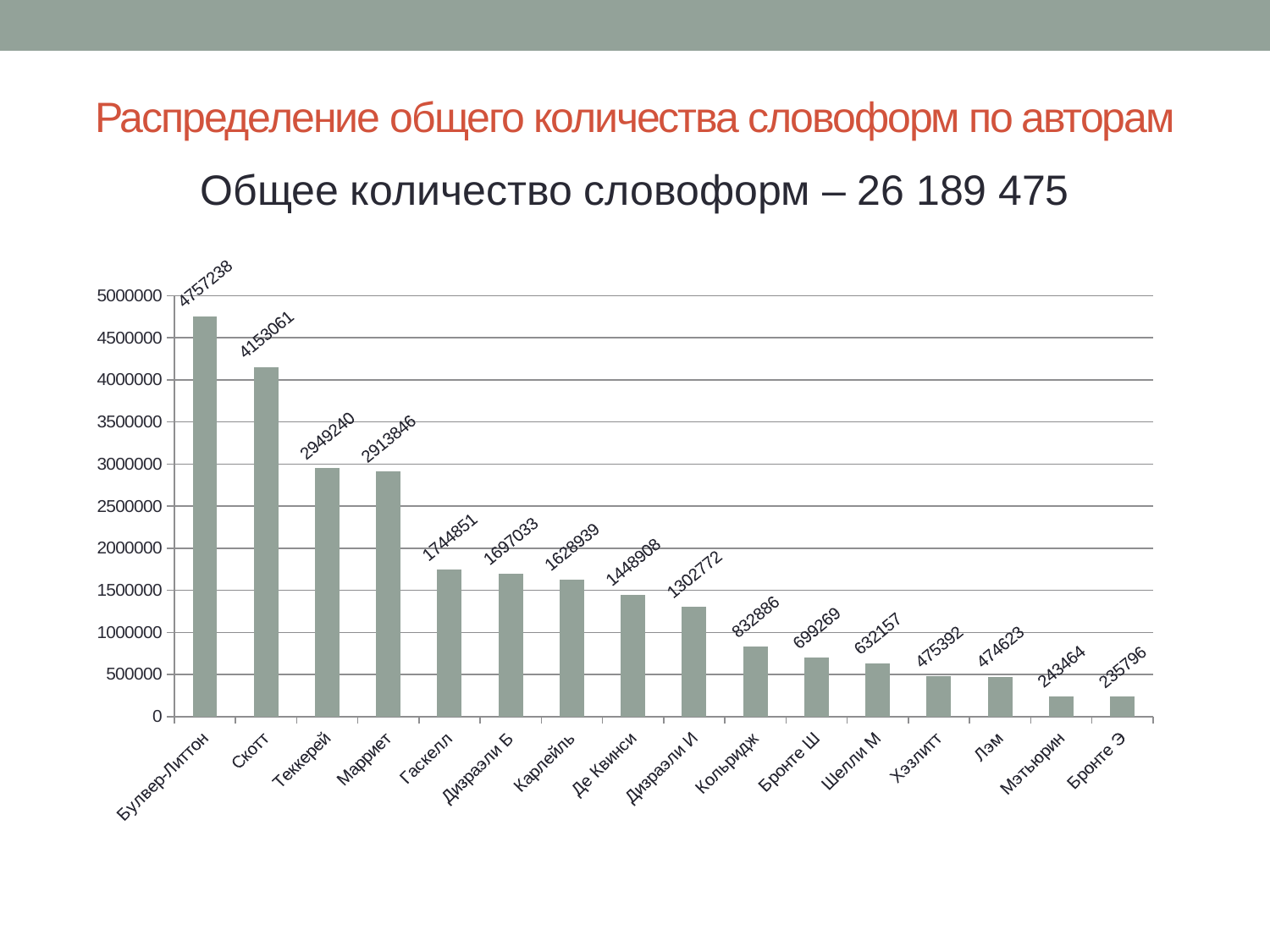
Which author has the highest value? Булвер-Литтон Do the values rise or fall from left to right along the x axis? fall Which is larger, the value for Де Квинси or the value for Шелли М? Де Квинси What is the value for Булвер-Литтон? 4757238 What kind of chart is shown on the slide? bar chart What is the value for Бронте Э? 235796 Is the value for Скотт greater or less than 4000000? greater Which author has the lowest value? Бронте Э How many authors are shown on the chart? 16 What is the difference between the values for Булвер-Литтон and Скотт? 604177 What is the value for Кольридж? 832886 What is the difference between the values for Теккерей and Марриет? 35394